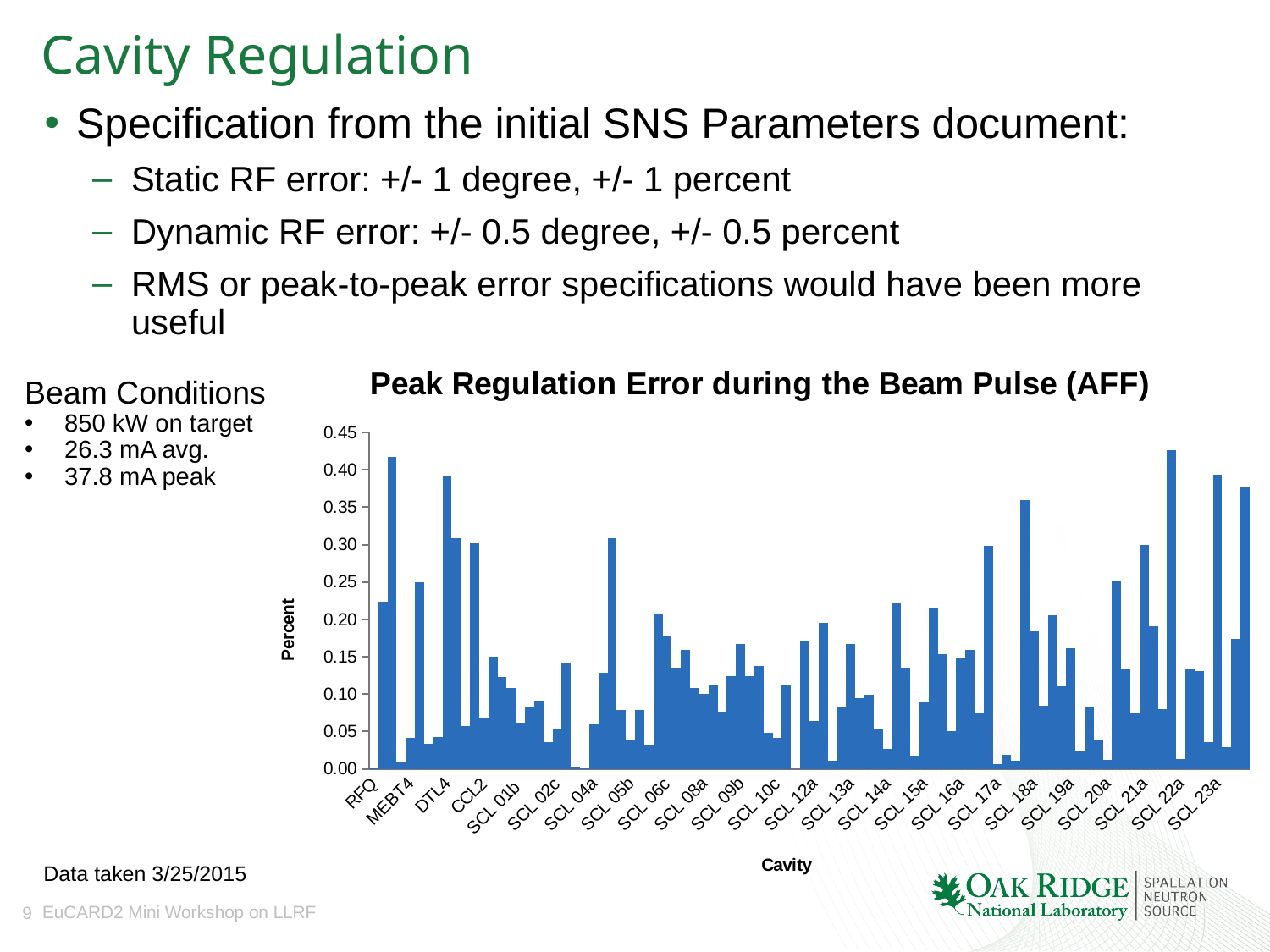
What type of chart is shown on the slide? bar chart What is the highest tick value shown on the vertical axis? 0.45 What is the label of the vertical axis of the chart? Percent Is the value for RFQ greater or less than 0.30? less What is the last category label on the horizontal axis? SCL 23a Do any bars in the chart exceed 0.45 on the vertical axis? No What is the lowest tick value shown on the vertical axis? 0.00 How many category labels are printed along the horizontal axis? 24 What is the first category label on the horizontal axis? RFQ What is the title of the chart? Peak Regulation Error during the Beam Pulse (AFF)